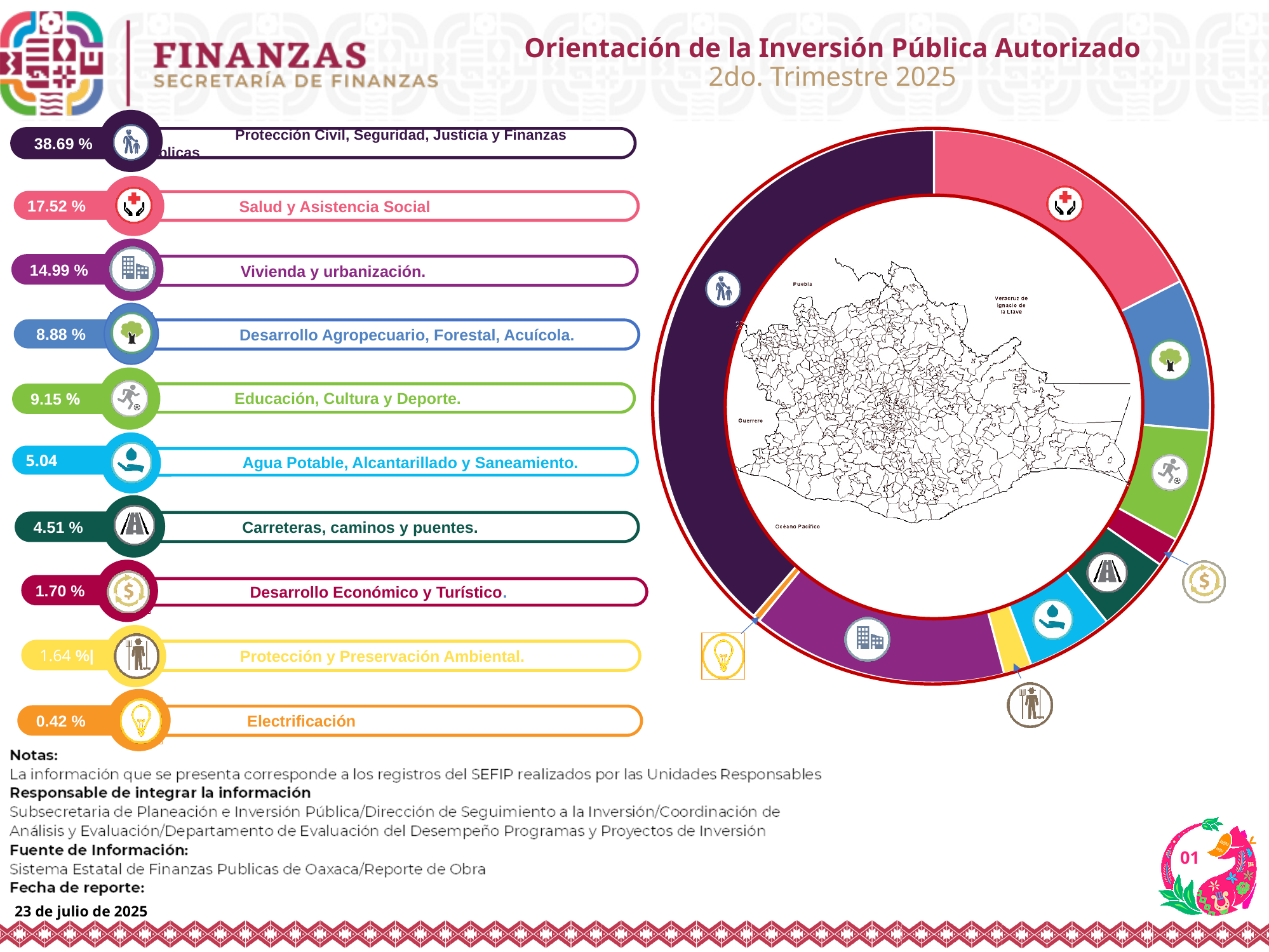
What percentage is shown for Salud y Asistencia Social? 17.52 % What is the combined share of Desarrollo Económico y Turístico and Protección y Preservación Ambiental? 3.34 % How many categories are listed in the chart's legend? 10 What is the title of the chart on the slide? Orientación de la Inversión Pública Autorizado 2do. Trimestre 2025 What percentage is shown for Carreteras, caminos y puentes? 4.51 % What value is shown for Agua Potable, Alcantarillado y Saneamiento? 5.04 What is the difference in percentage points between Protección Civil, Seguridad, Justicia y Finanzas and Salud y Asistencia Social? 21.17 What percentage is shown for Vivienda y urbanización? 14.99 % Which has a larger share: Educación, Cultura y Deporte or Desarrollo Agropecuario, Forestal, Acuícola? Educación, Cultura y Deporte Which category has the largest share of the authorized public investment? Protección Civil, Seguridad, Justicia y Finanzas What kind of chart is shown on the slide? Pie chart (donut) Which category has the smallest share? Electrificación